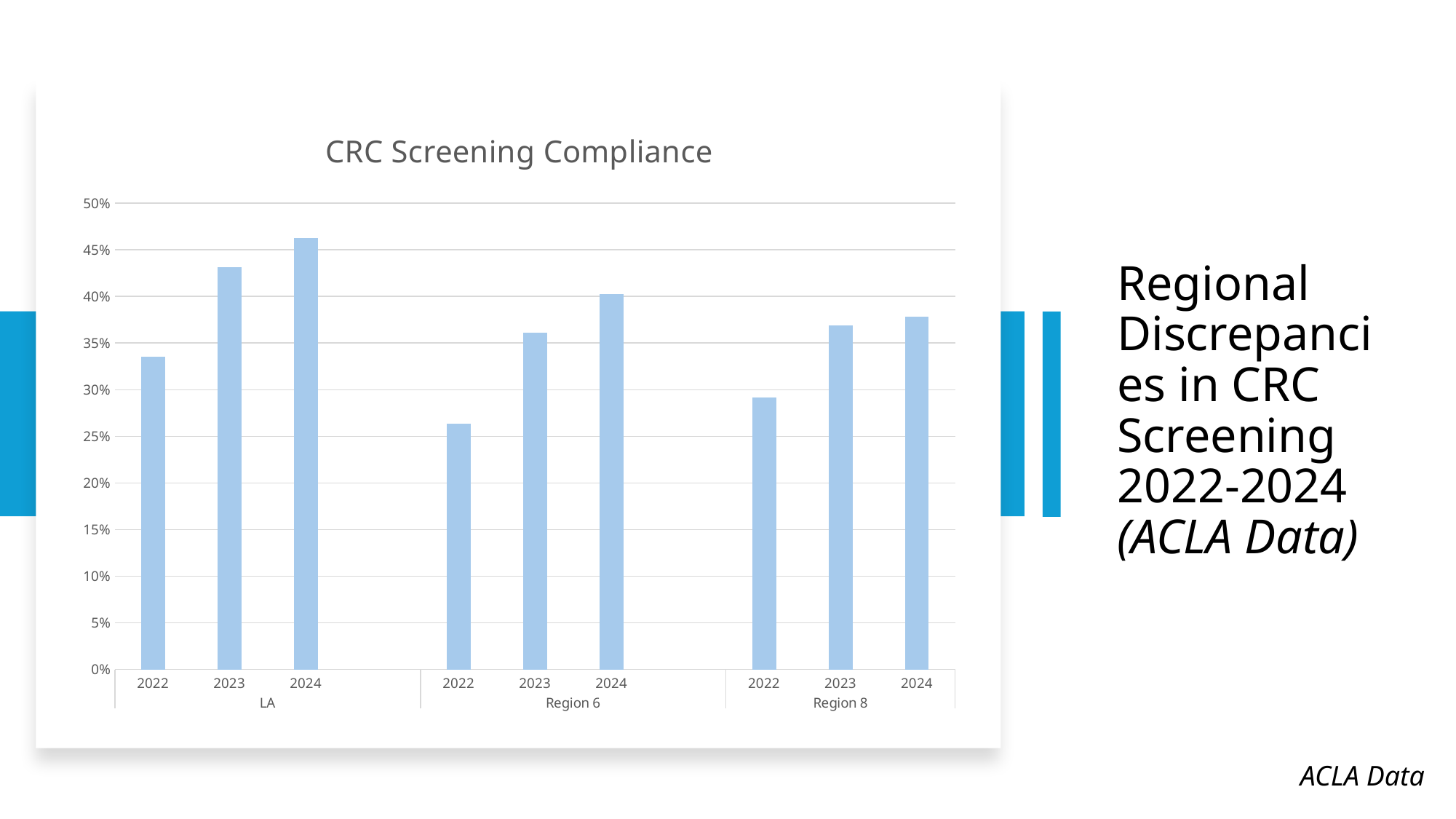
Which region and year has the lowest CRC screening compliance? Region 6, 2022 How many regions are shown along the x axis of the chart? 3 Is the value for LA in 2024 greater or less than 45%? greater Is the value for Region 6 in 2022 greater or less than 30%? less Which is larger, the value for LA in 2023 or the value for Region 6 in 2024? LA in 2023 What type of chart is shown on the slide? bar chart Do the values for Region 6 rise or fall from 2022 to 2024? rise How many bars are plotted in the chart? 9 Which region and year has the highest CRC screening compliance? LA, 2024 What is the title of the chart? CRC Screening Compliance Is the value for Region 8 in 2022 greater or less than 30%? less